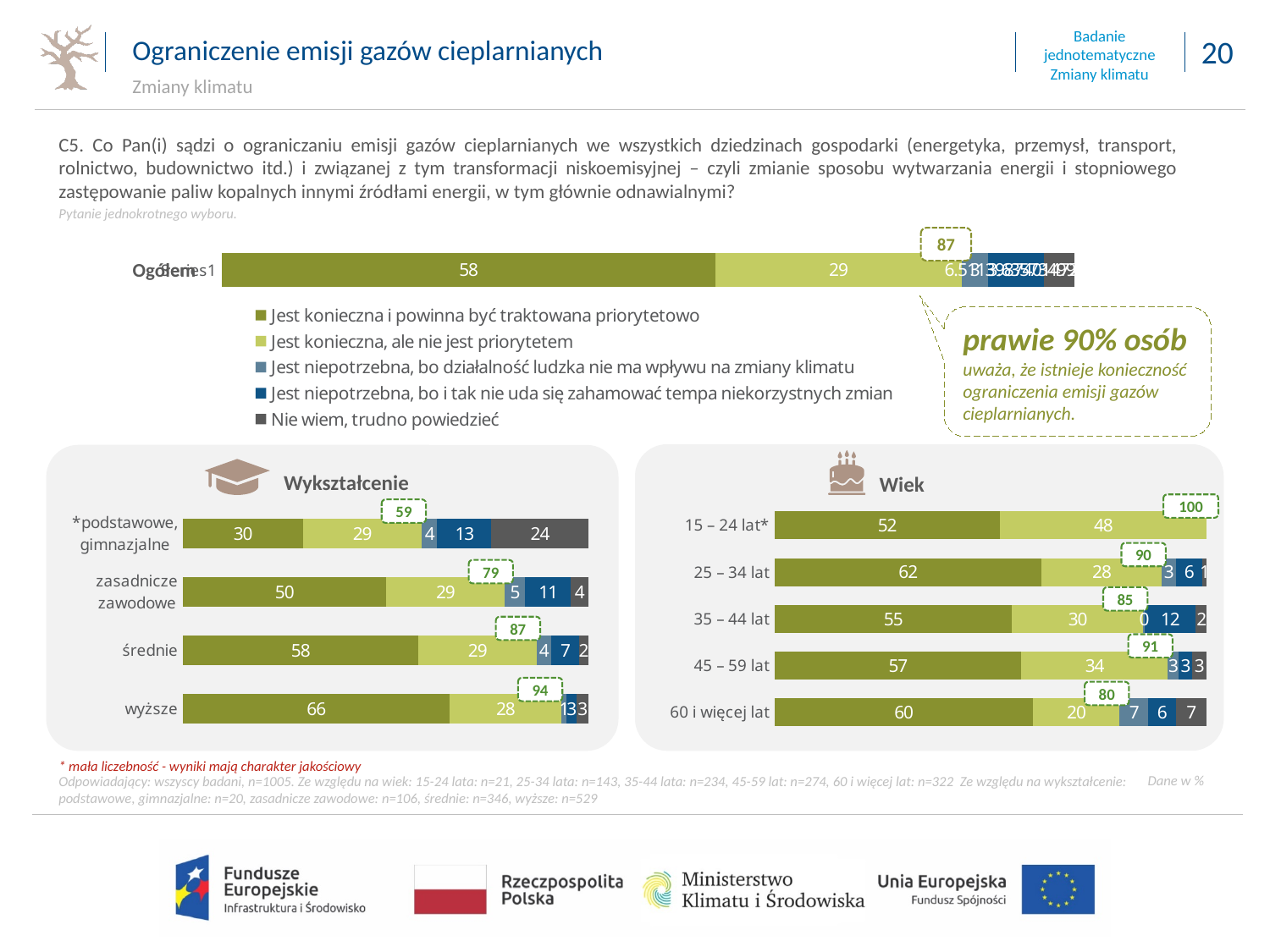
In the Wiek chart, which has the larger value for "Jest konieczna i powinna być traktowana priorytetowo": 45 – 59 lat or 60 i więcej lat? 60 i więcej lat In the Wykształcenie chart, what is the value of "Jest konieczna i powinna być traktowana priorytetowo" for wyższe? 66 What kind of chart is the Wykształcenie chart? Stacked bar chart How many age groups are shown in the Wiek chart? 5 How many series does the legend list? 5 In the Wykształcenie chart, what is the value of "Nie wiem, trudno powiedzieć" for *podstawowe, gimnazjalne? 24 In the Wykształcenie chart, which education group has the lowest value for "Jest konieczna i powinna być traktowana priorytetowo"? *podstawowe, gimnazjalne In the Wiek chart, what is the value of "Jest konieczna i powinna być traktowana priorytetowo" for 25 – 34 lat? 62 In the Wykształcenie chart, what is the difference between wyższe and *podstawowe, gimnazjalne for "Jest konieczna i powinna być traktowana priorytetowo"? 36 In the Wiek chart, what is the value of "Nie wiem, trudno powiedzieć" for 60 i więcej lat? 7 In the Ogółem chart, what is the value of "Jest konieczna, ale nie jest priorytetem"? 29 In the Wiek chart, which age group has the highest value for "Jest konieczna i powinna być traktowana priorytetowo"? 25 – 34 lat